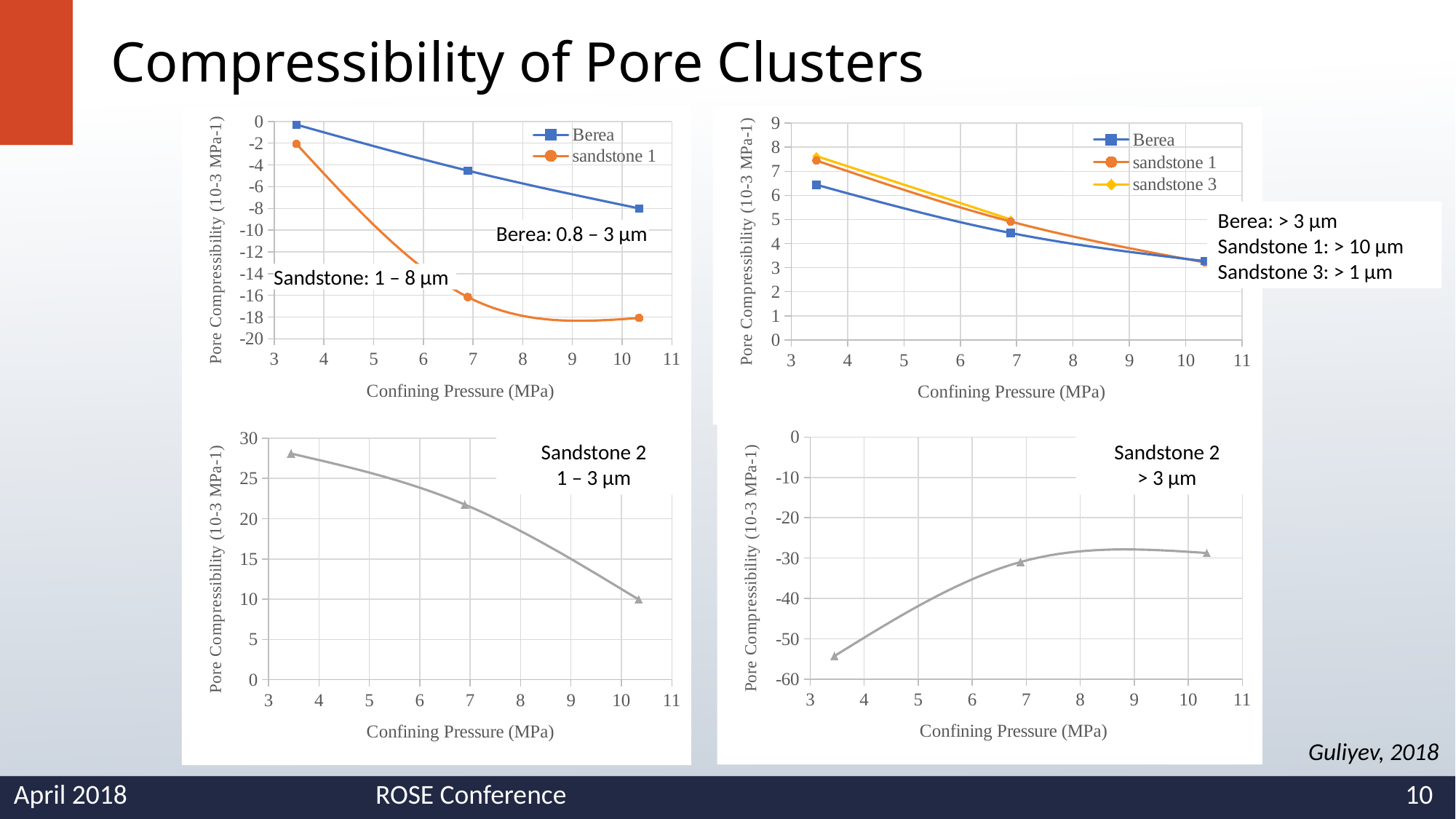
What are the legend entries of the top-right chart? Berea, sandstone 1, sandstone 3 What kind of chart is the top-left chart on the slide? line chart In the bottom-left chart (Sandstone 2, 1 – 3 µm), do the values rise or fall as confining pressure increases? fall In the bottom-right chart (Sandstone 2, > 3 µm), is the value at the lowest confining pressure greater or less than -50? less In the bottom-left chart (Sandstone 2, 1 – 3 µm), is the value at the lowest confining pressure greater or less than 25? greater What is the x-axis label of the bottom-right chart? Confining Pressure (MPa) How many series does the legend of the top-left chart list? 2 In the bottom-left chart (Sandstone 2, 1 – 3 µm), how many data points are plotted? 3 How many series does the legend of the top-right chart list? 3 In the top-right chart, at the lowest confining pressure, which series has the larger value: Berea or sandstone 1? sandstone 1 In the top-right chart, does the Berea series rise or fall as confining pressure increases? fall In the top-left chart, is the sandstone 1 value at the highest confining pressure greater or less than -16? less